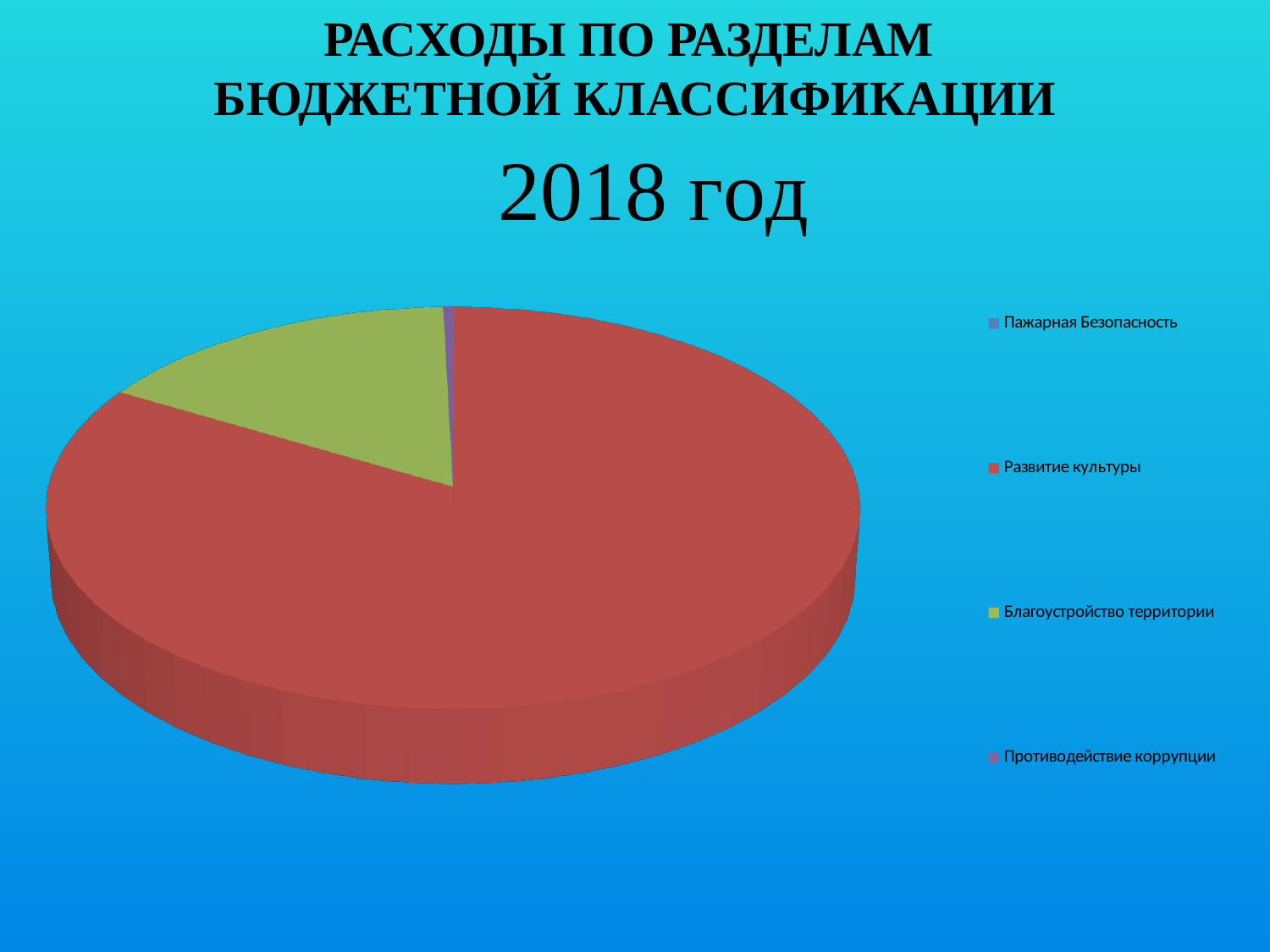
Which category has the largest slice of the pie chart? Развитие культуры What colour is the slice for Благоустройство территории? green Which slice is larger: Благоустройство территории or Пажарная Безопасность? Благоустройство территории What kind of chart is shown on the slide? pie chart Which category has the second-largest slice of the pie chart? Благоустройство территории How many categories does the legend of the pie chart list? 4 Which slice is larger: Развитие культуры or Благоустройство территории? Развитие культуры Which year does the chart on the slide refer to? 2018 год